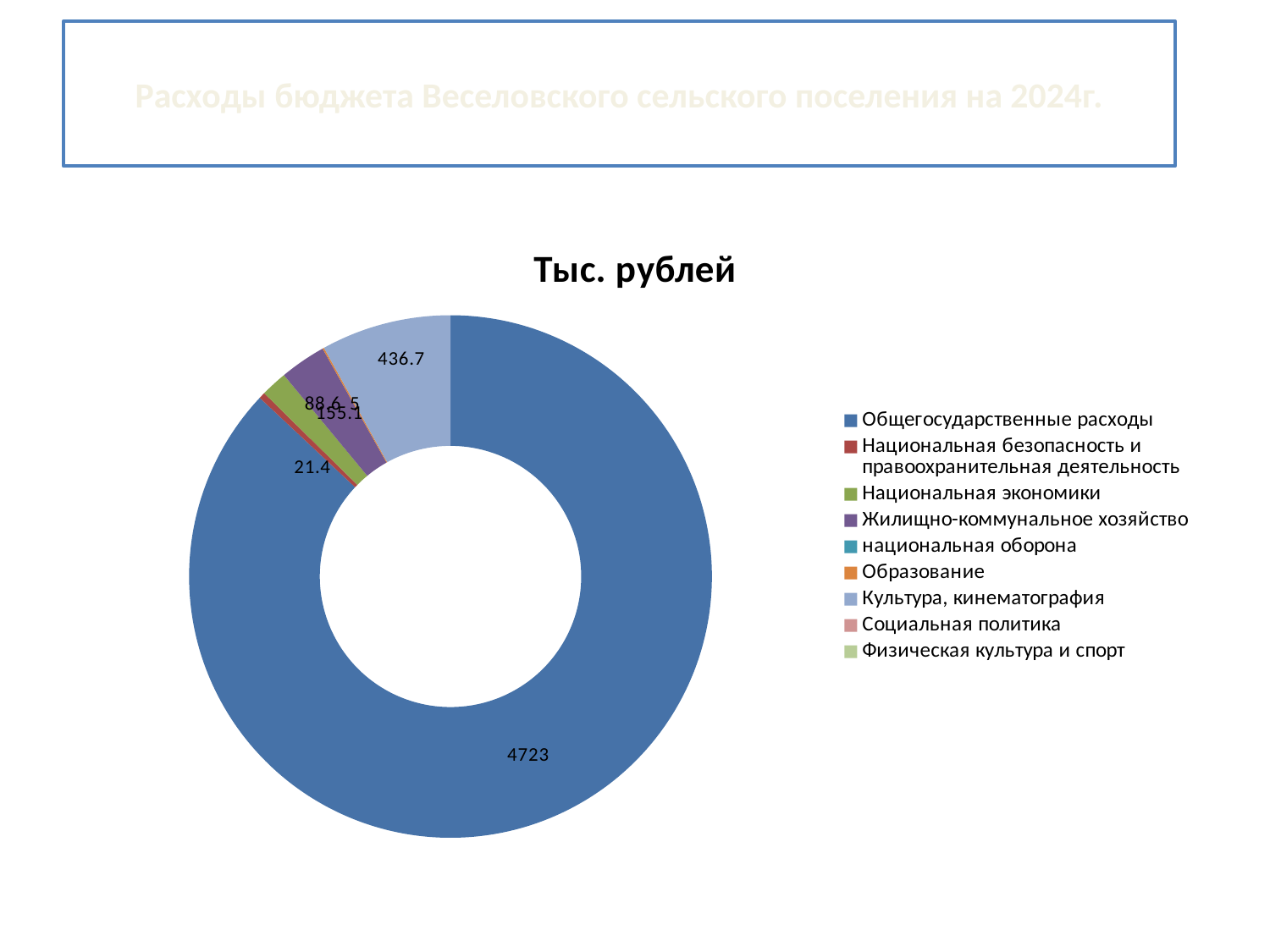
Which is larger: Общегосударственные расходы or Культура, кинематография? Общегосударственные расходы Which category has the largest slice in the chart? Общегосударственные расходы What kind of chart is shown on the slide? Doughnut (pie) chart Which is larger: Культура, кинематография or Национальная безопасность и правоохранительная деятельность? Культура, кинематография What is the value for Национальная безопасность и правоохранительная деятельность? 21.4 What is the title of the chart? Тыс. рублей How many categories does the chart legend list? 9 What colour represents Общегосударственные расходы in the chart? Blue What is the value for Общегосударственные расходы? 4723 What is the value for Жилищно-коммунальное хозяйство? 155.1 What is the value for Культура, кинематография? 436.7 What is the difference between the values for Общегосударственные расходы and Культура, кинематография? 4286.3